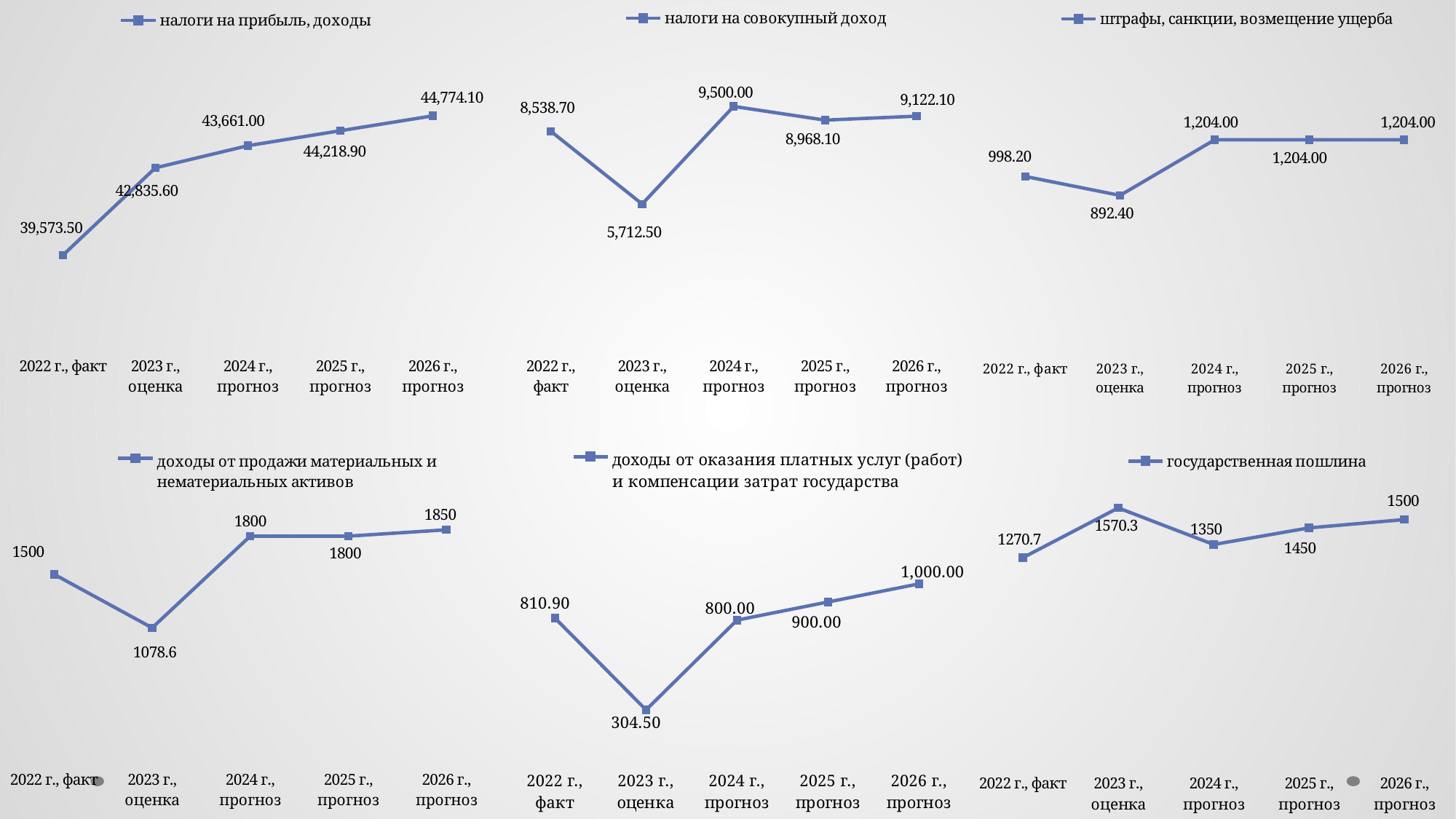
In the chart 'государственная пошлина', what is the value for 2023 г., оценка? 1570.3 In the chart 'штрафы, санкции, возмещение ущерба', what is the value for 2023 г., оценка? 892.40 In the chart 'доходы от оказания платных услуг (работ) и компенсации затрат государства', which is larger: the value for 2022 г., факт or for 2023 г., оценка? 2022 г., факт In the chart 'налоги на совокупный доход', what is the difference between the 2024 г., прогноз value and the 2023 г., оценка value? 3,787.50 In the chart 'налоги на совокупный доход', which year has the lowest value? 2023 г., оценка In the chart 'штрафы, санкции, возмещение ущерба', how many data points are plotted? 5 In the chart 'доходы от продажи материальных и нематериальных активов', which year has the highest value? 2026 г., прогноз In the chart 'налоги на совокупный доход', what is the value for 2024 г., прогноз? 9,500.00 In the chart 'доходы от продажи материальных и нематериальных активов', what is the value for 2023 г., оценка? 1078.6 In the chart 'налоги на прибыль, доходы', do the values rise or fall from 2022 to 2026? rise What type of chart is the 'государственная пошлина' chart? line chart In the chart 'налоги на прибыль, доходы', what is the value for 2022 г., факт? 39,573.50